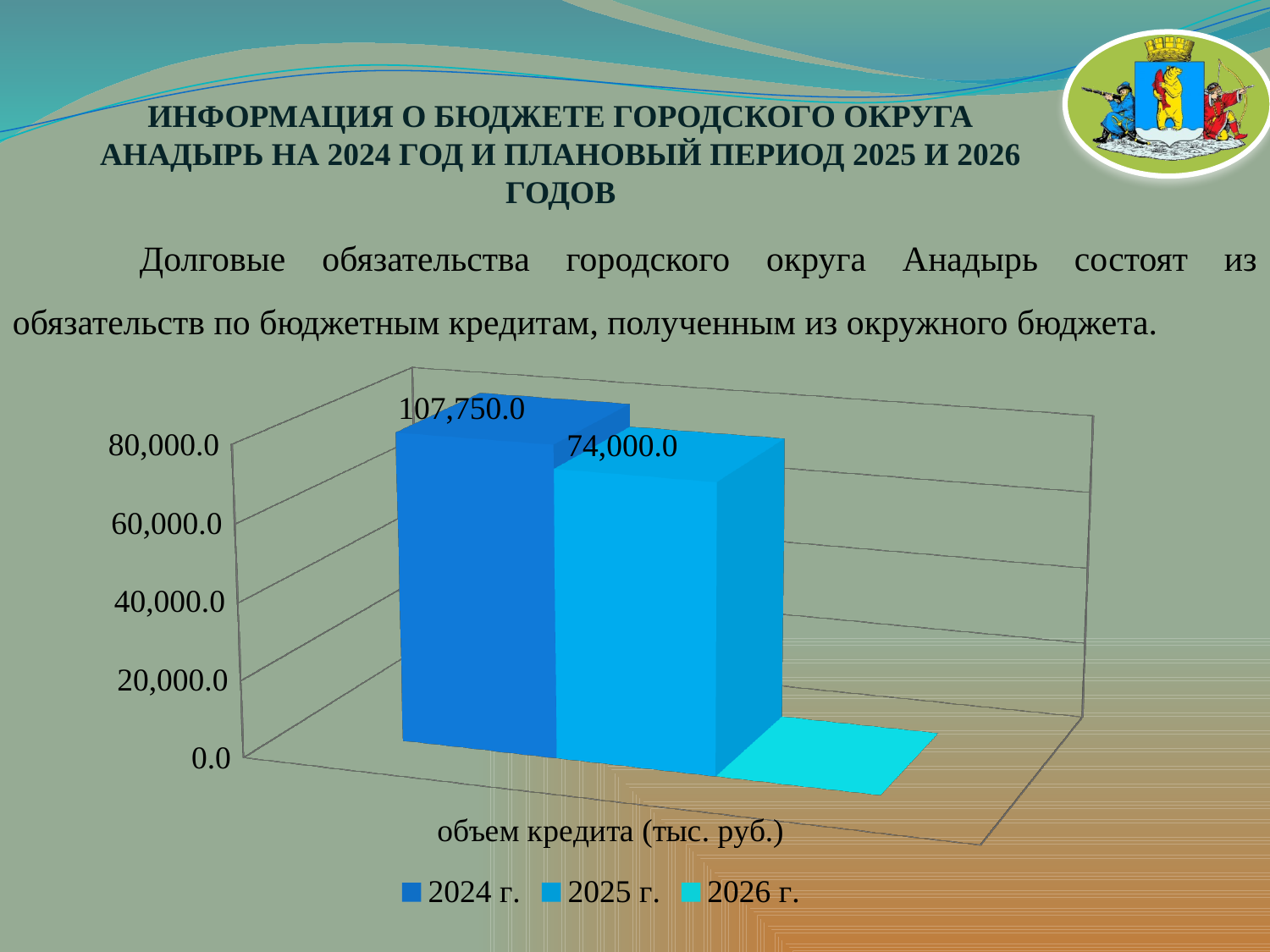
Which series has the highest value in the chart? 2024 г. Is the value for 2026 г. greater or less than 20,000.0? less What is the category label shown below the bars? объем кредита (тыс. руб.) What is the value for the 2024 г. series in the chart? 107,750.0 Is the value for 2025 г. greater or less than 60,000.0? greater Which is larger, the value for 2024 г. or the value for 2025 г.? 2024 г. Is the value for 2024 г. greater or less than 80,000.0? greater What is the difference between the 2024 г. value and the 2025 г. value? 33,750.0 Which series has the lowest value in the chart? 2026 г. What kind of chart is shown on the slide? bar chart What is the value for the 2025 г. series in the chart? 74,000.0 How many series does the legend list? 3